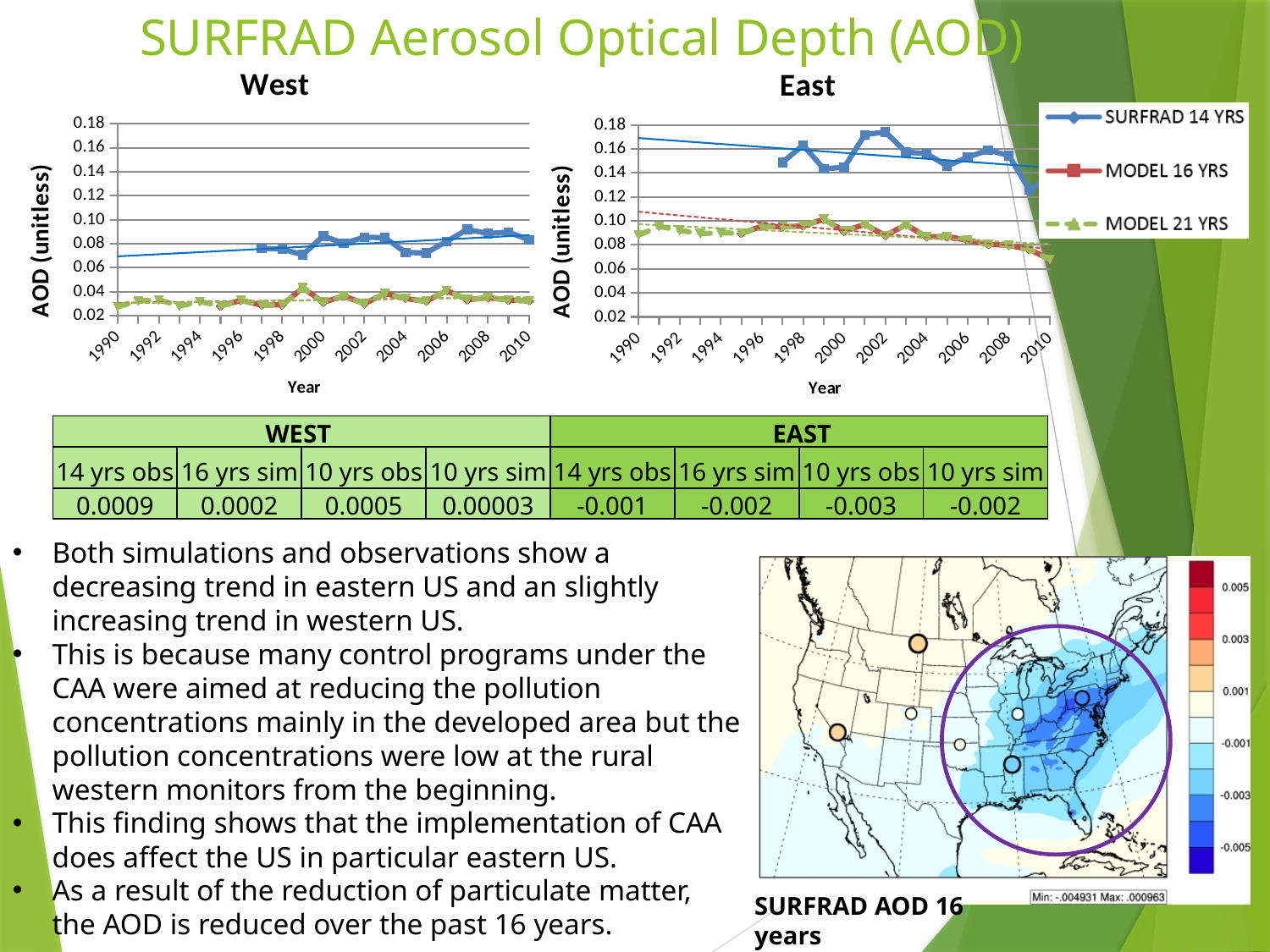
What kind of chart is the West chart? line chart What is the label on the y axis of the East chart? AOD (unitless) In the West chart, is the MODEL 16 YRS value for 2000 greater or less than 0.06? less In the West chart, does the SURFRAD 14 YRS trend line rise or fall from 1990 to 2010? rise What is the title of the slide containing the two line charts? SURFRAD Aerosol Optical Depth (AOD) How many series does the legend list for the East chart? 3 In the East chart, do the SURFRAD 14 YRS values rise or fall from 1998 to 2010 overall? fall In the West chart, is the SURFRAD 14 YRS value for 2008 greater or less than 0.06? greater In the East chart, which series has the highest values in 2002? SURFRAD 14 YRS In the East chart, is the MODEL 21 YRS value for 2008 greater or less than 0.12? less In the West chart, which series has higher values throughout, SURFRAD 14 YRS or MODEL 16 YRS? SURFRAD 14 YRS